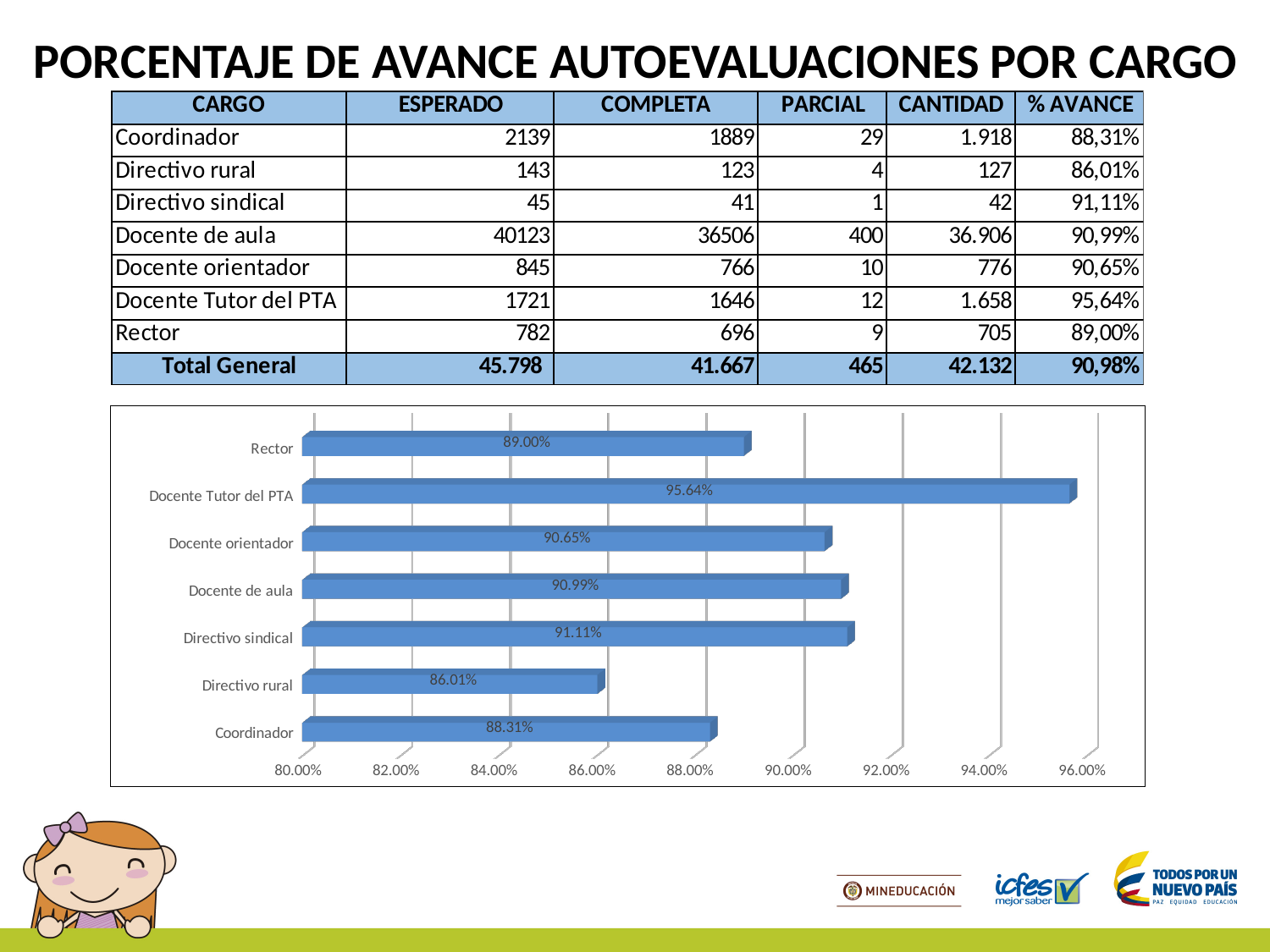
What is the lowest value shown on the horizontal axis of the chart? 80.00% What is the value shown for Directivo rural in the chart? 86.01% Which is larger in the chart, the value for Docente de aula or the value for Docente orientador? Docente de aula What is the value shown for Rector in the chart? 89.00% What is the value shown for Coordinador in the chart? 88.31% How many categories are plotted in the chart? 7 What is the difference between the values for Docente Tutor del PTA and Directivo rural in the chart? 9.63% What is the value shown for Docente Tutor del PTA in the chart? 95.64% Which category has the highest value in the chart? Docente Tutor del PTA Which category has the lowest value in the chart? Directivo rural Is the value for Coordinador in the chart greater or less than 90.00%? less What type of chart is shown on the slide? bar chart